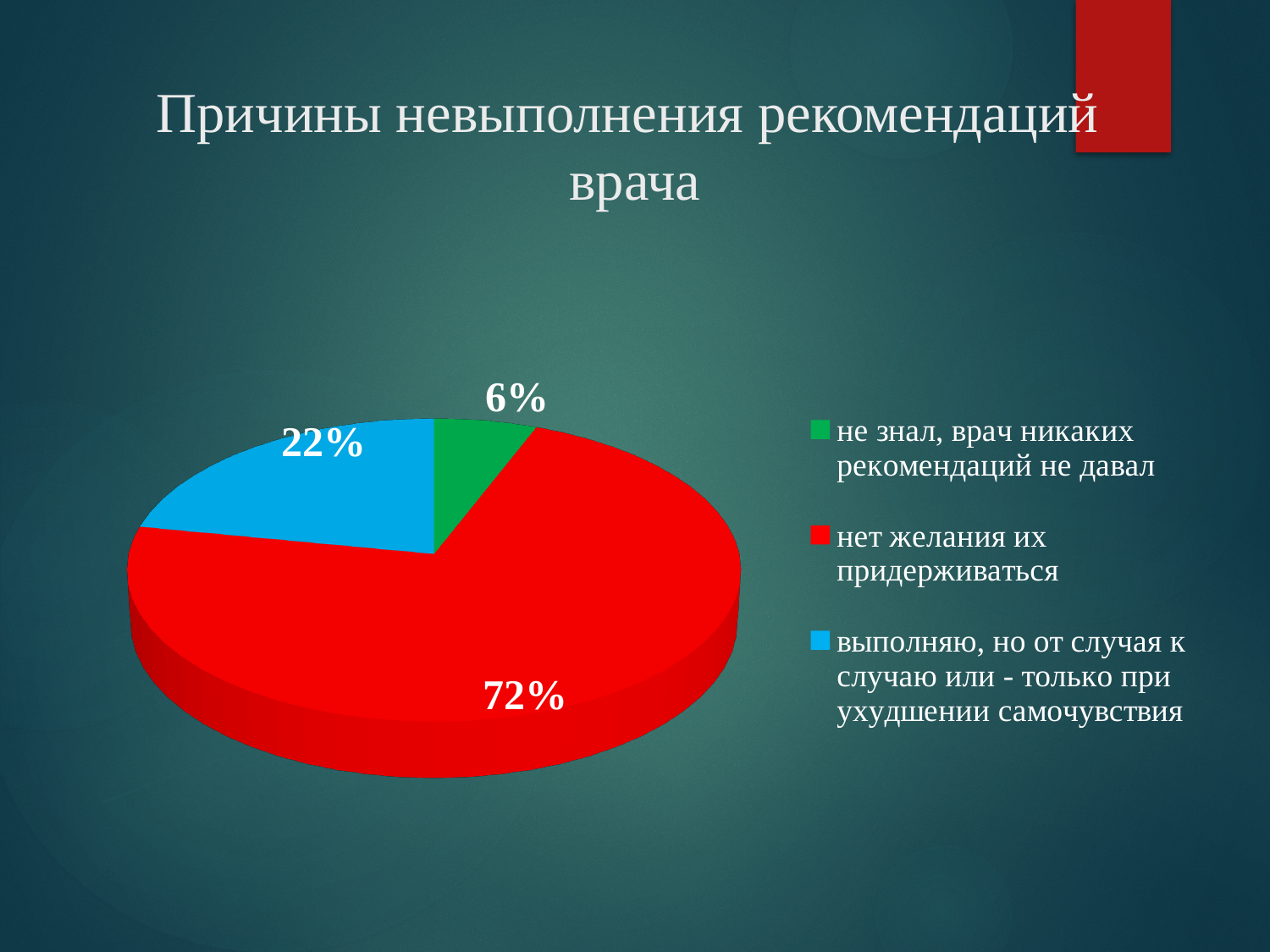
What is the difference in percentage points between the 'выполняю, но от случая к случаю или - только при ухудшении самочувствия' slice and the 'не знал, врач никаких рекомендаций не давал' slice? 16 What type of chart is shown on the slide? pie chart What share of the pie is labelled 'нет желания их придерживаться'? 72% Which category has the smallest slice of the pie? не знал, врач никаких рекомендаций не давал How many categories does the pie chart have? 3 What colour is the slice for 'нет желания их придерживаться'? red Which category has the largest slice of the pie? нет желания их придерживаться What is the difference in percentage points between the 'нет желания их придерживаться' slice and the 'выполняю, но от случая к случаю или - только при ухудшении самочувствия' slice? 50 What share of the pie is labelled 'выполняю, но от случая к случаю или - только при ухудшении самочувствия'? 22% What is the title of the chart on the slide? Причины невыполнения рекомендаций врача What share of the pie is labelled 'не знал, врач никаких рекомендаций не давал'? 6% Which is larger: the slice for 'выполняю, но от случая к случаю или - только при ухудшении самочувствия' or the slice for 'не знал, врач никаких рекомендаций не давал'? выполняю, но от случая к случаю или - только при ухудшении самочувствия